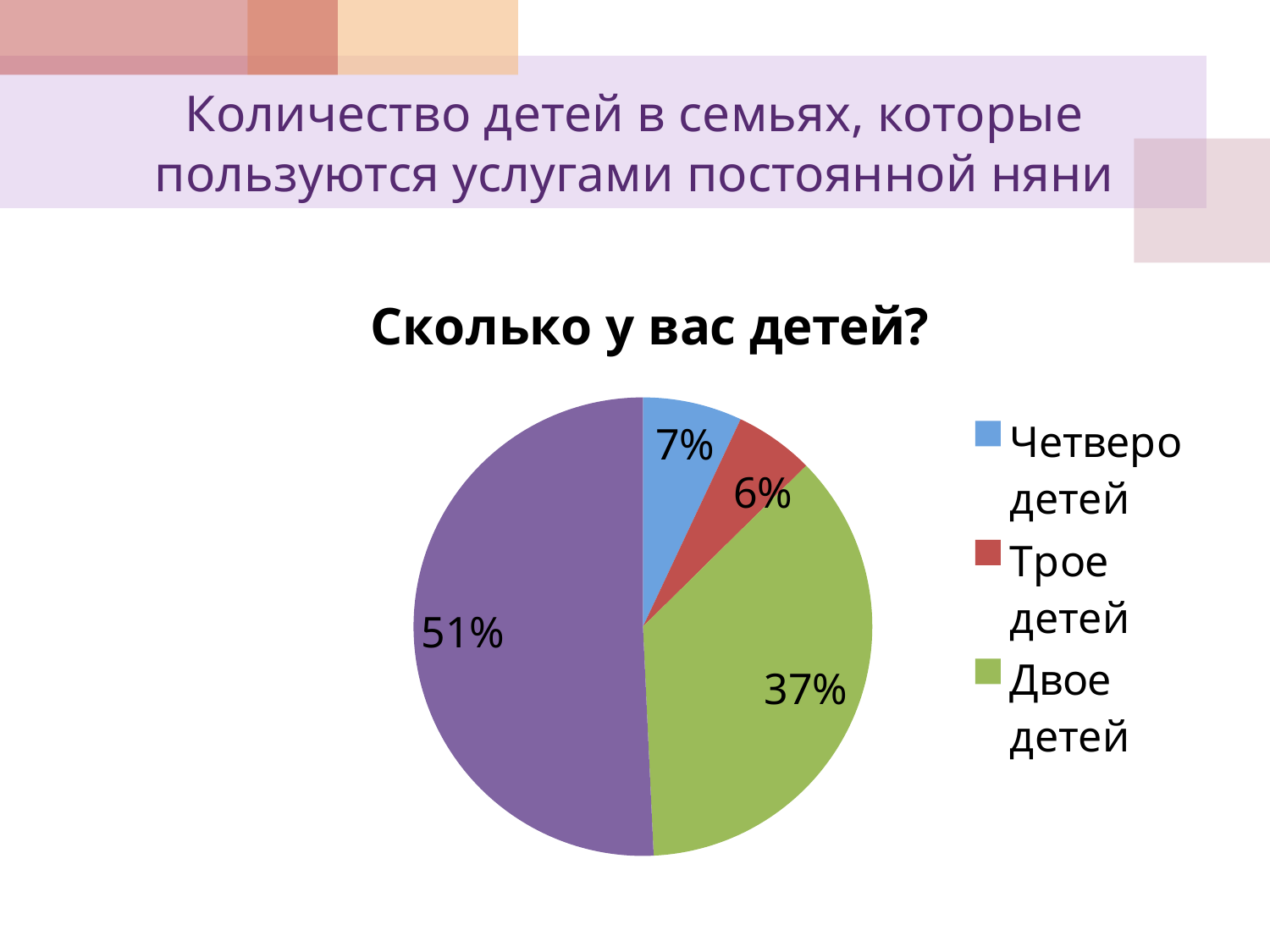
How many slices does the pie chart have? 4 What is the difference between the "Двое детей" slice and the "Трое детей" slice? 31% How many entries does the legend list? 3 What is the value shown on the largest slice of the pie? 51% What share of the pie does "Двое детей" have? 37% What is the difference between the "Четверо детей" slice and the "Трое детей" slice? 1% What share of the pie does "Трое детей" have? 6% Which is larger, the slice for "Четверо детей" or the slice for "Трое детей"? Четверо детей What is the title of the chart? Сколько у вас детей? Which of the legend categories has the smallest slice? Трое детей What share of the pie does "Четверо детей" have? 7% What kind of chart is shown on the slide? pie chart